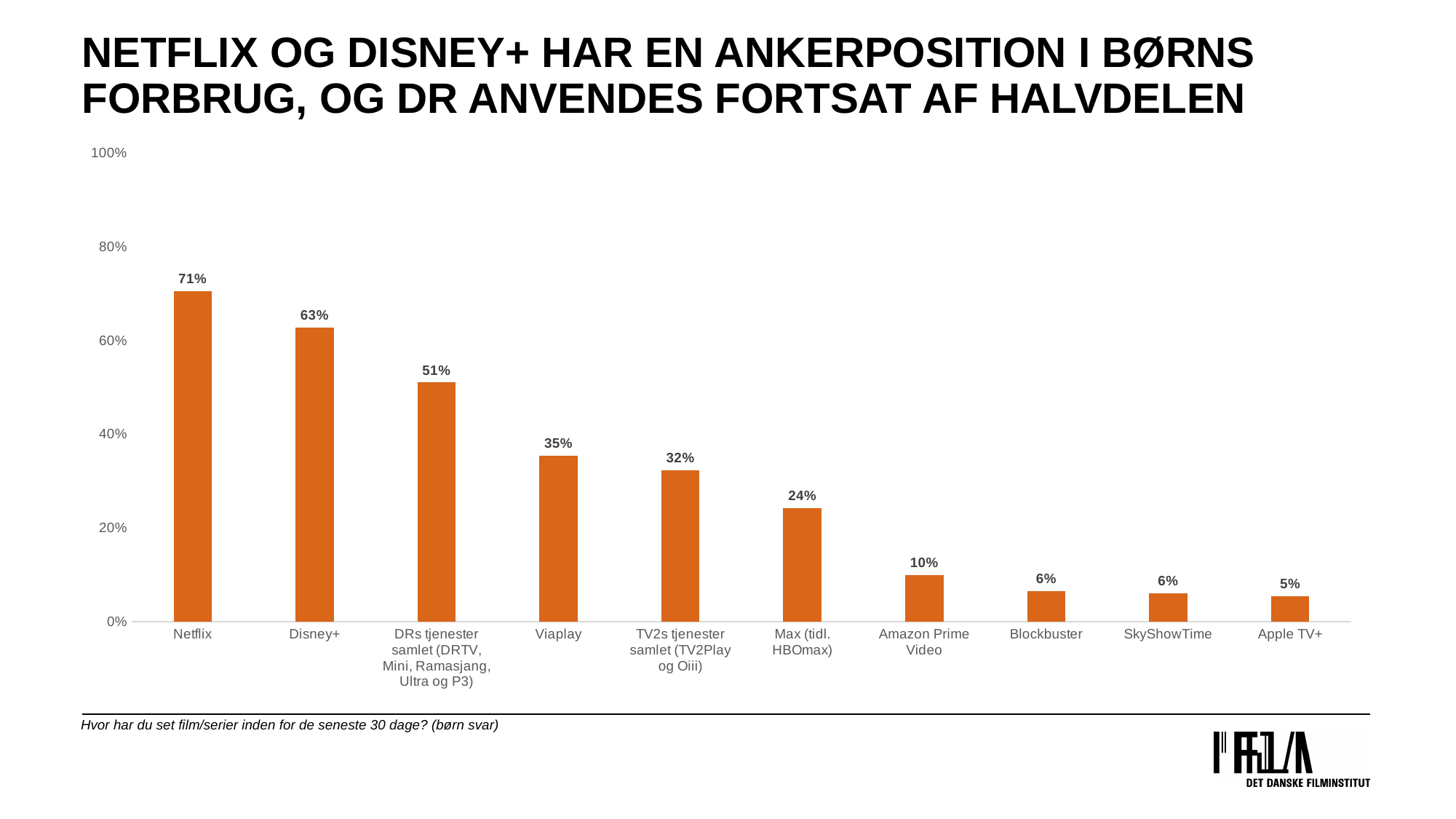
Which category has the lowest value? Apple TV+ What is the difference between the values for DRs tjenester samlet and TV2s tjenester samlet? 19% What is the value for Netflix? 71% Is the value for Amazon Prime Video greater or less than 20%? less Which category has the highest value? Netflix What is the value for Max (tidl. HBOmax)? 24% Do the values rise or fall from left to right along the x axis? Fall How many categories are shown on the x axis? 10 What kind of chart is shown on the slide? Bar chart What is the value for Viaplay? 35% Which is larger, the value for Viaplay or the value for TV2s tjenester samlet? Viaplay What is the difference between the values for Netflix and Disney+? 8%